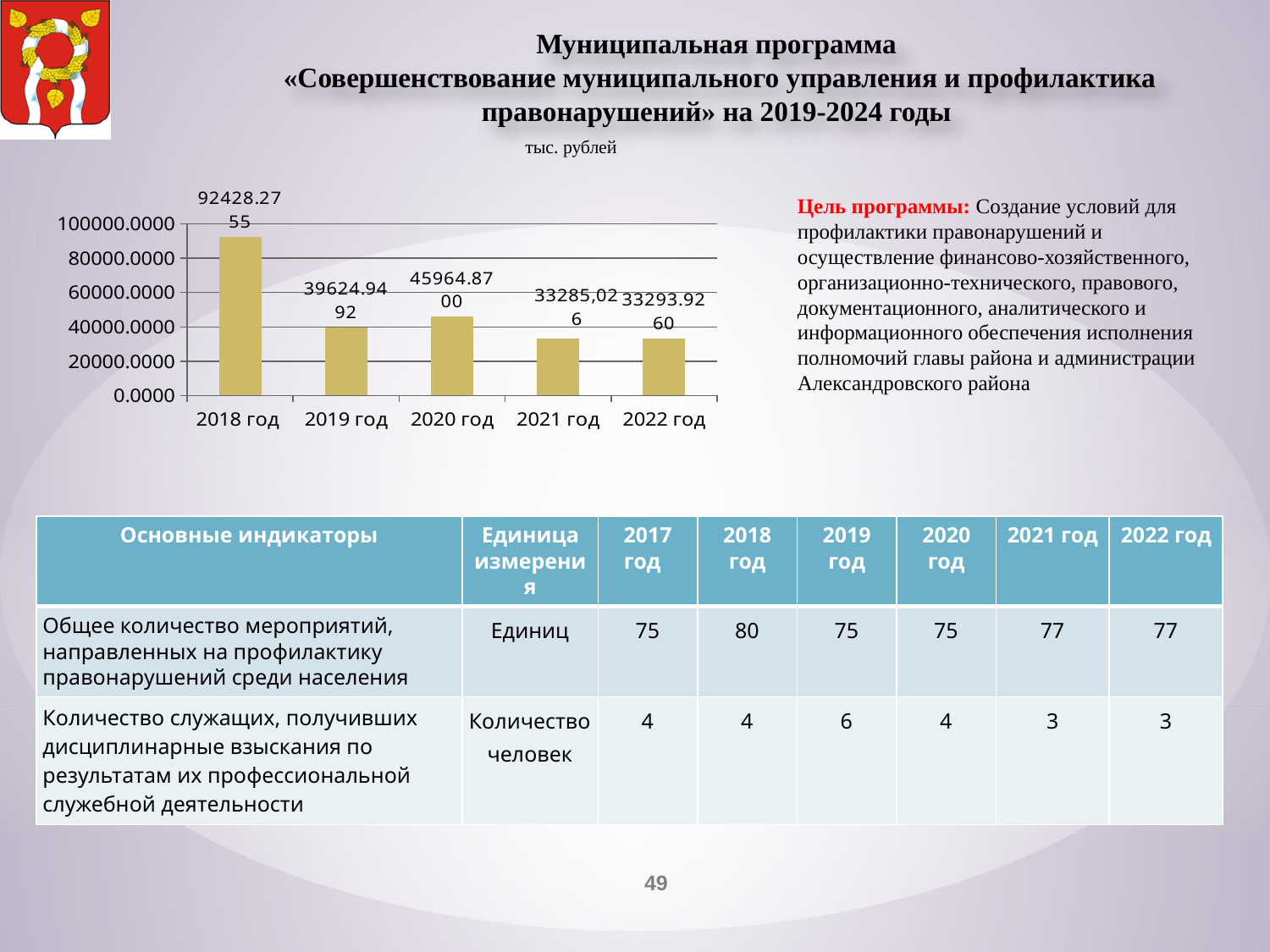
What is the difference between the values for 2018 год and 2019 год in the bar chart? 52803.3263 Is the value for 2021 год greater or less than 40000? less Which is larger in the bar chart, the value for 2019 год or 2020 год? 2020 год Is the value for 2020 год greater or less than 40000? greater What type of chart is shown on the slide? bar chart What is the value shown for 2020 год in the bar chart? 45964.8700 What is the value shown for 2018 год in the bar chart? 92428.2755 Which year has the highest value in the bar chart? 2018 год What unit of measurement is indicated above the bar chart? тыс. рублей What is the value shown for 2019 год in the bar chart? 39624.9492 Does the value rise or fall from 2018 год to 2019 год in the bar chart? fall How many years (categories) are plotted in the bar chart? 5